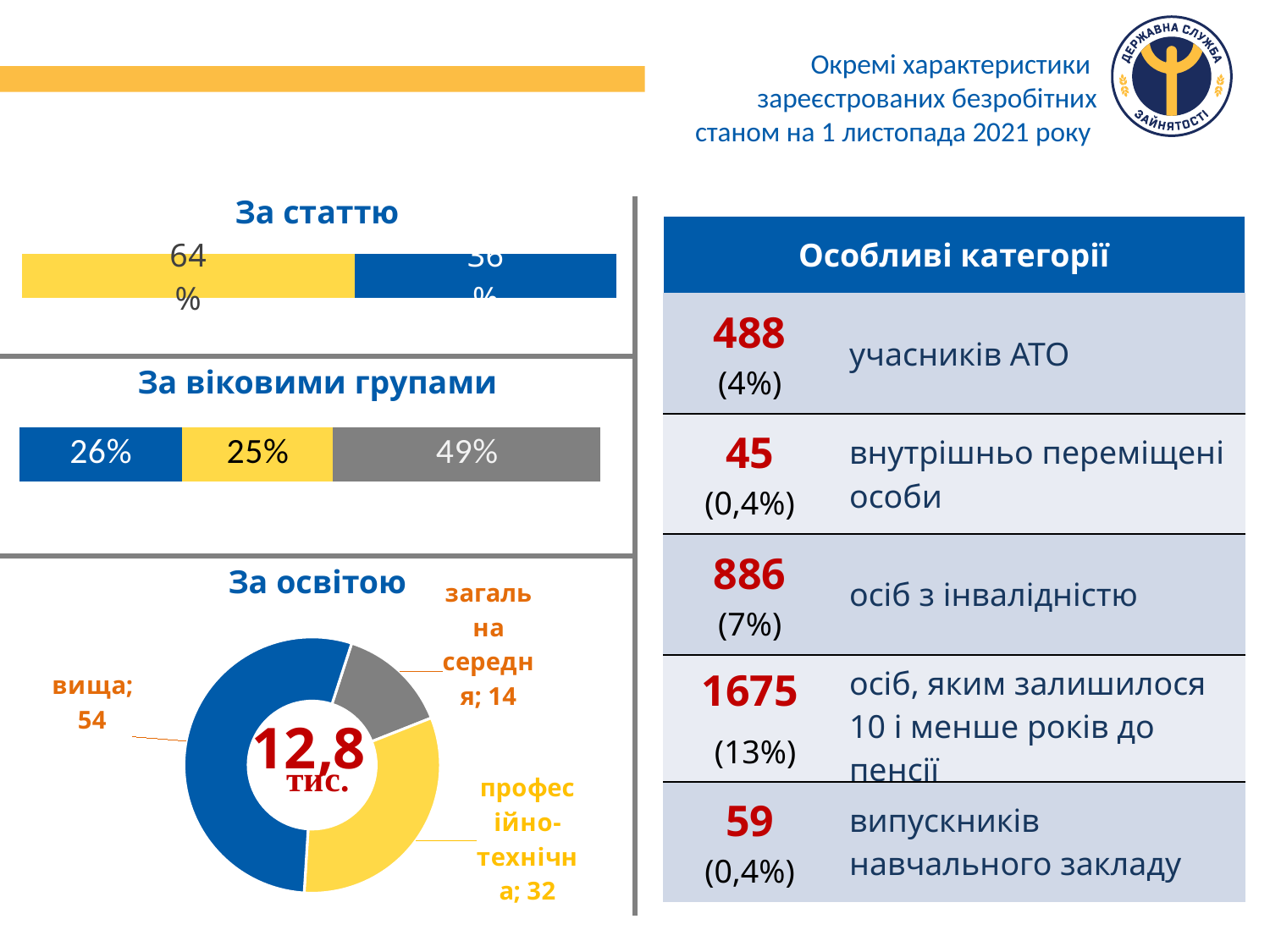
In the 'За віковими групами' chart, what is the value of the grey segment? 49% In the 'За освітою' chart, which category has the smallest share? загальна середня In the 'За освітою' chart, what is the value for 'загальна середня'? 14 What total is printed in the centre of the 'За освітою' chart? 12,8 тис. In the 'За віковими групами' chart, which segment is larger: the blue one or the grey one? The grey one What kind of chart is the 'За освітою' chart? Doughnut chart In the 'За статтю' chart, what is the value of the yellow segment? 64% In the 'За освітою' chart, what is the value for 'вища'? 54 In the 'За освітою' chart, what is the value for 'професійно-технічна'? 32 In the 'За освітою' chart, how many categories are shown? 3 In the 'За освітою' chart, which category has the largest share? вища In the 'За освітою' chart, what is the difference between the values for 'вища' and 'професійно-технічна'? 22